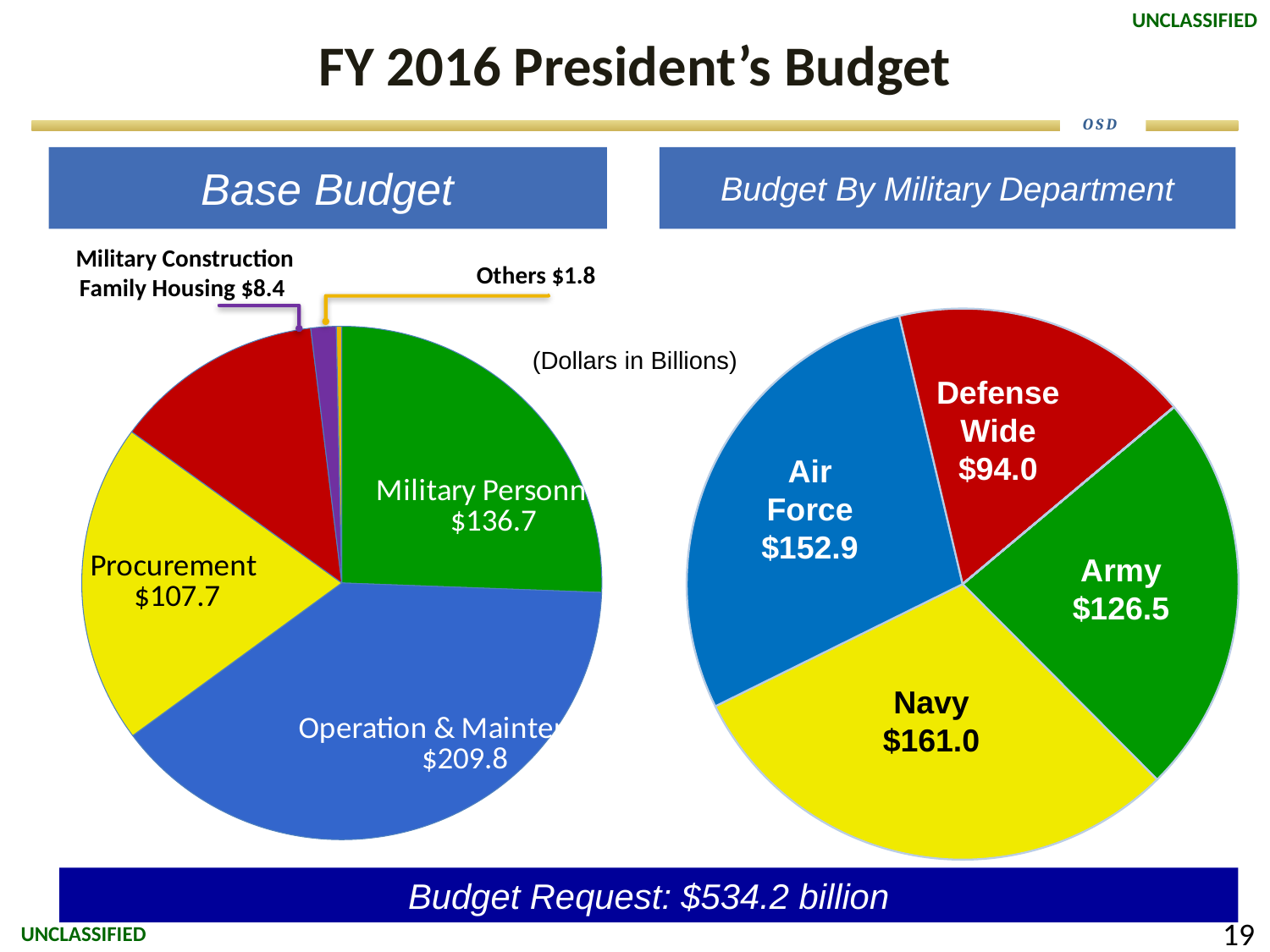
In the Budget By Military Department chart, what is the value for Defense Wide? $94.0 In the Budget By Military Department chart, what is the difference between the Navy and Army values? $34.5 In the Base Budget chart, what is the value for Others? $1.8 In the Base Budget chart, which category has the largest value? Operation & Maintenance In the Budget By Military Department chart, which is larger, Air Force or Army? Air Force In the Budget By Military Department chart, what is the value for the Navy? $161.0 In the Budget By Military Department chart, which department has the largest budget? Navy In the Budget By Military Department chart, which category has the smallest value? Defense Wide In the Base Budget chart, what is the value for Procurement? $107.7 In the Base Budget chart, what is the difference between Operation & Maintenance and Military Personnel? $73.1 What type of chart is the Base Budget chart? Pie chart How many slices does the Budget By Military Department chart have? 4